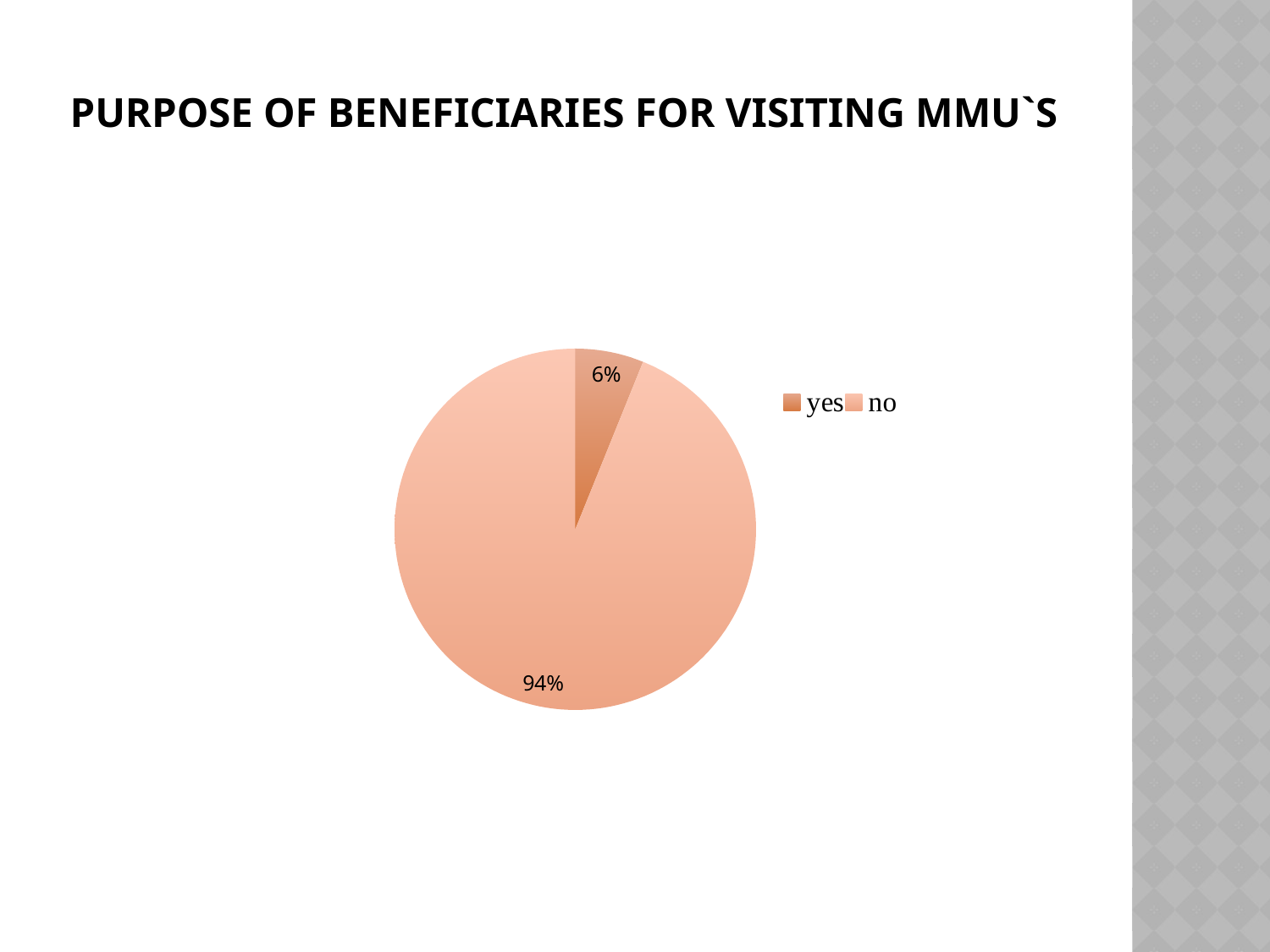
How many entries does the legend list? 2 What percentage of the pie is labelled "yes"? 6% What percentage of the pie is labelled "no"? 94% Which slice of the pie is the largest? no What are the two legend entries of the pie chart? yes, no What share of the pie does the "no" slice take? 94% Which is larger, the "yes" slice or the "no" slice? no How many slices does the pie chart have? 2 What is the title of the slide containing the pie chart? PURPOSE OF BENEFICIARIES FOR VISITING MMU`S What is the difference in percentage points between the "no" slice and the "yes" slice? 88 Which slice of the pie is the smallest? yes What kind of chart is shown on the slide? pie chart